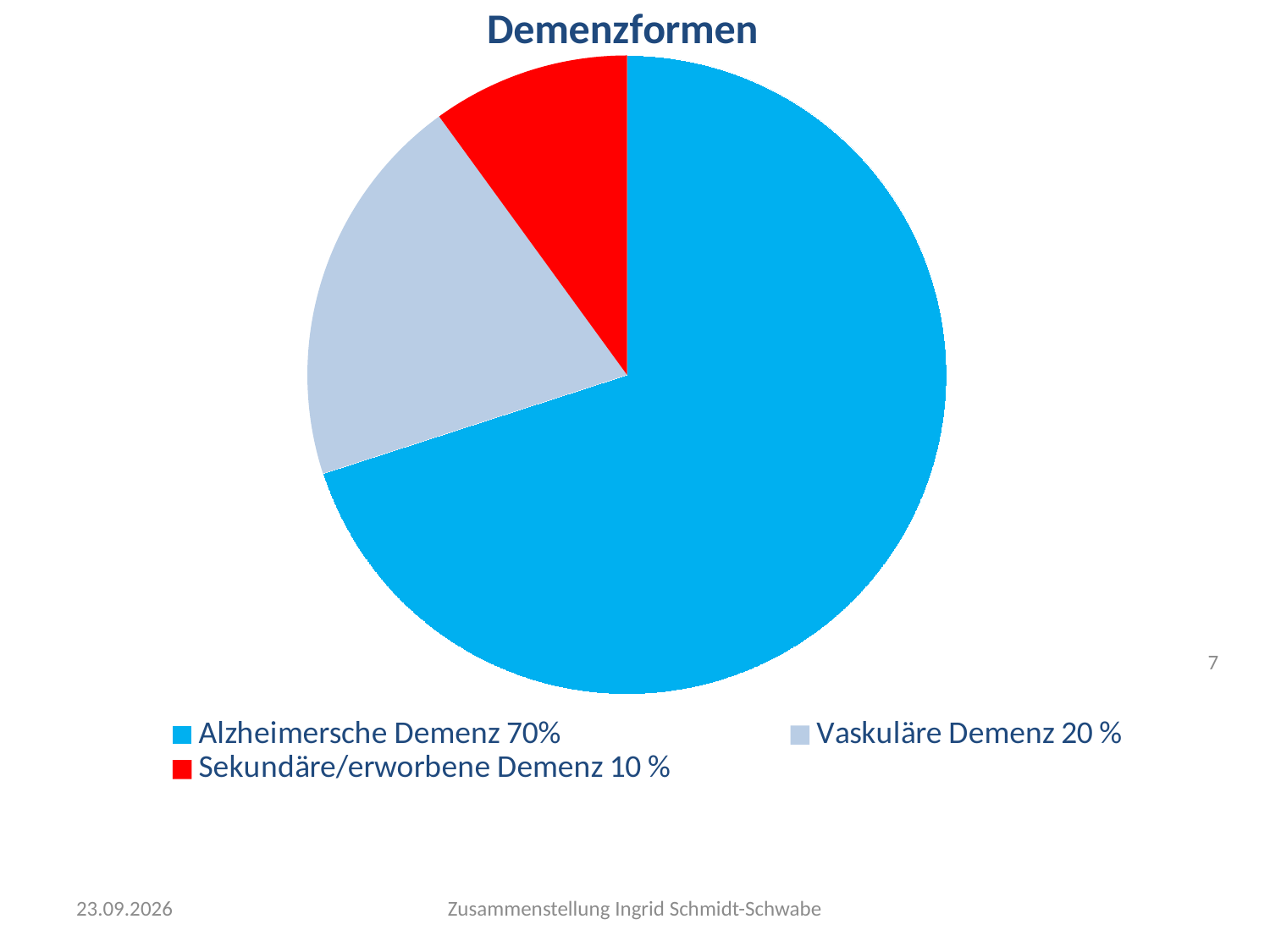
What is the difference in percentage points between Alzheimersche Demenz and Vaskuläre Demenz? 50 Which form of dementia has the smallest slice in the pie chart? Sekundäre/erworbene Demenz What share of the pie does Vaskuläre Demenz represent? 20 % Is the share for Alzheimersche Demenz greater or less than 50%? greater What colour is the slice for Sekundäre/erworbene Demenz? red What kind of chart is shown on the slide? pie chart Which form of dementia has the largest slice in the pie chart? Alzheimersche Demenz How many slices does the pie chart have? 3 What share of the pie does Alzheimersche Demenz represent? 70% What share of the pie does Sekundäre/erworbene Demenz represent? 10 % Which is larger: the slice for Vaskuläre Demenz or the slice for Sekundäre/erworbene Demenz? Vaskuläre Demenz What is the title of the chart? Demenzformen